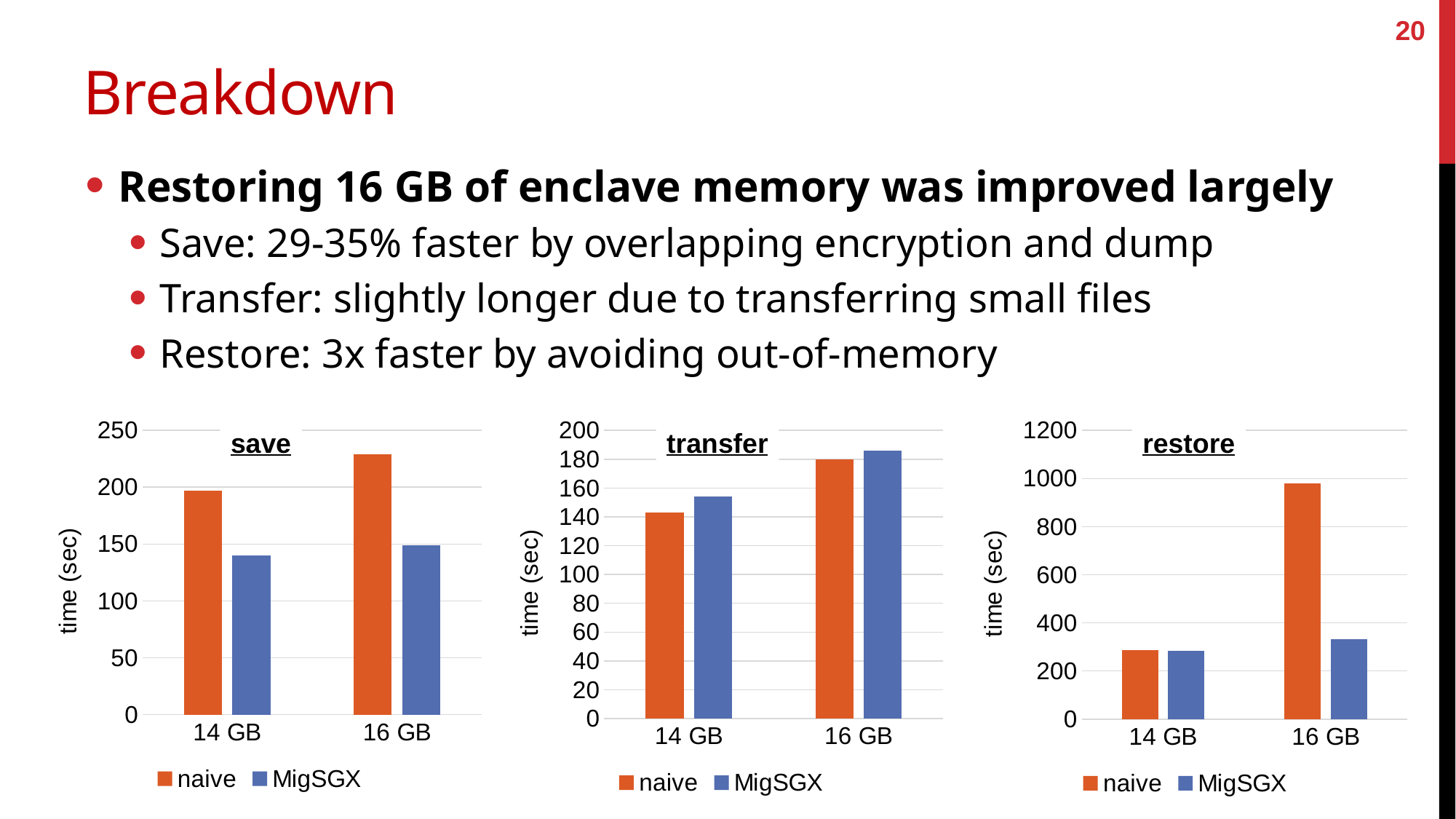
In the 'save' chart, is the value for naive at 16 GB greater or less than 200? greater In the 'save' chart, is the value for MigSGX at 14 GB greater or less than 150? less How many memory-size categories are shown on the x axis of the 'restore' chart? 2 In the 'restore' chart, is the value for naive at 16 GB greater or less than 800? greater What colour represents the naive series in the charts? orange In the 'restore' chart, which bar is the highest? naive at 16 GB How many series does the legend of the 'transfer' chart list? 2 In the 'transfer' chart, which is larger at 14 GB: naive or MigSGX? MigSGX In the 'save' chart, does the naive series rise or fall from 14 GB to 16 GB? rise What kind of chart is the 'save' chart? bar chart